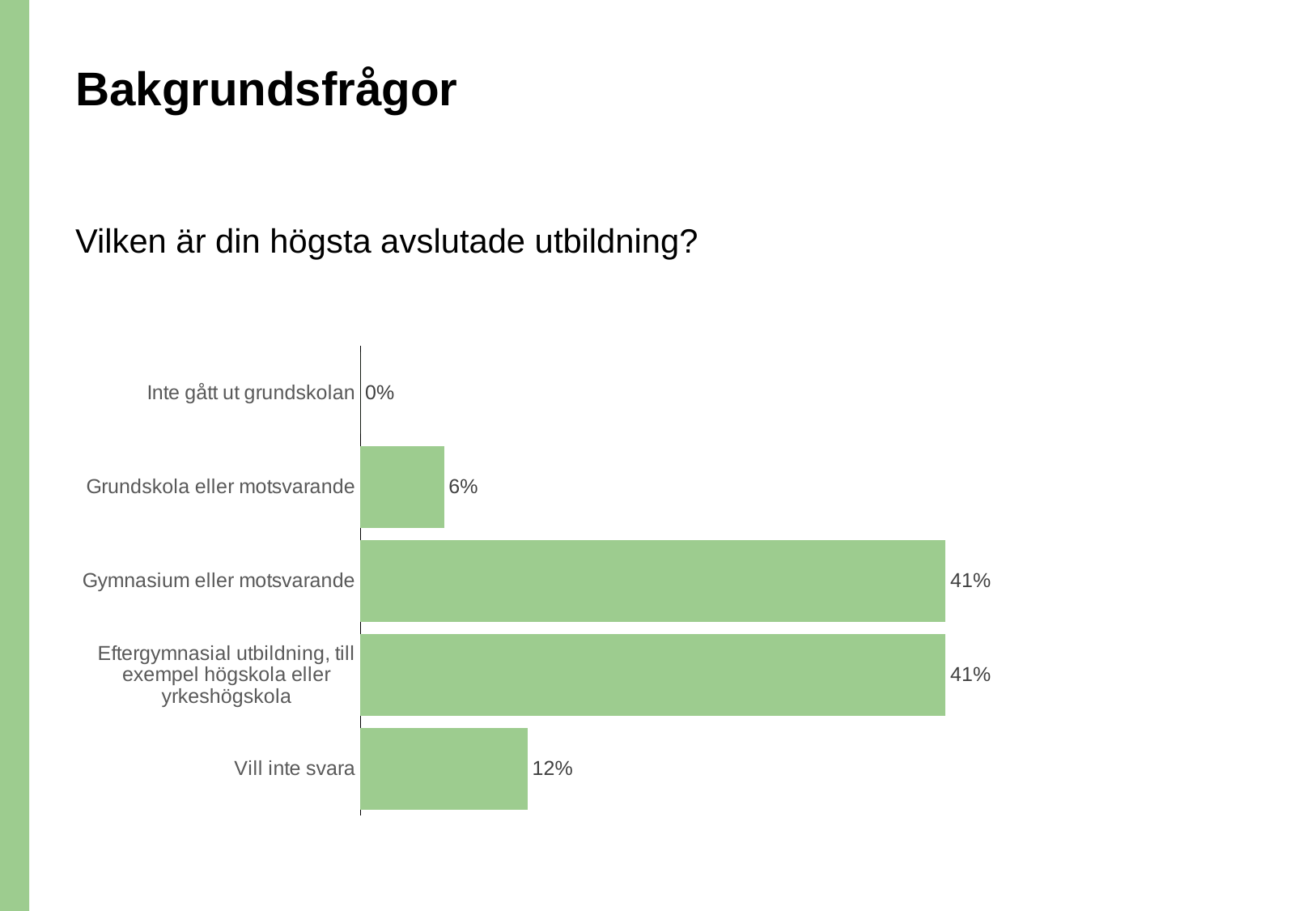
What kind of chart is shown on the slide? Bar chart What is the difference between the values for "Vill inte svara" and "Grundskola eller motsvarande"? 6% What is the value for "Eftergymnasial utbildning, till exempel högskola eller yrkeshögskola"? 41% What is the value for "Gymnasium eller motsvarande"? 41% What is the value for "Inte gått ut grundskolan"? 0% What is the value for "Vill inte svara"? 12% What is the difference between the values for "Gymnasium eller motsvarande" and "Vill inte svara"? 29% Which category has the lowest value? Inte gått ut grundskolan Which is larger, the value for "Vill inte svara" or the value for "Grundskola eller motsvarande"? Vill inte svara How many categories are shown in the chart? 5 What is the value for "Grundskola eller motsvarande"? 6% What question does the chart on the slide present results for? Vilken är din högsta avslutade utbildning?